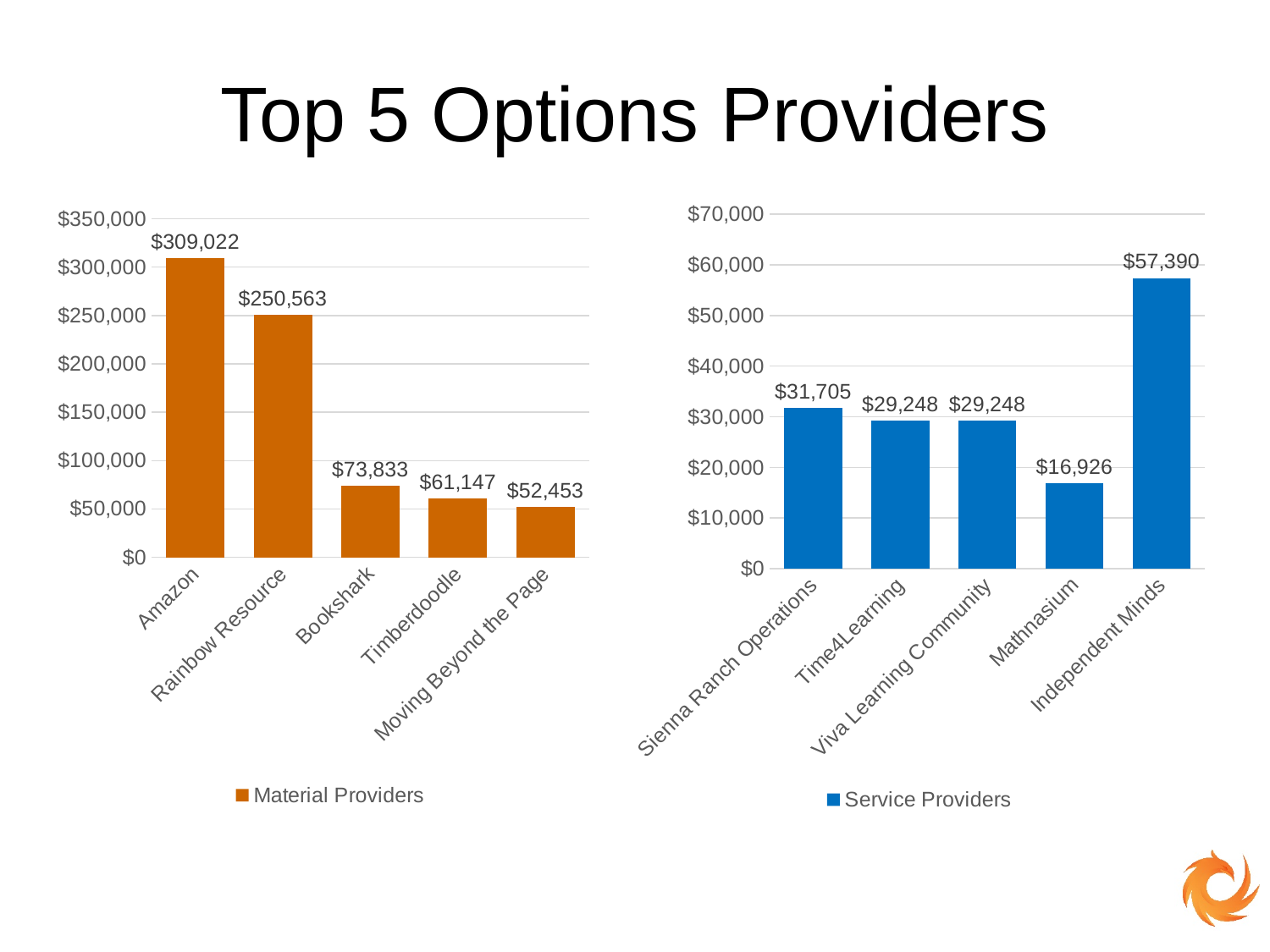
On the right chart (Service Providers), what is the difference between the values for Independent Minds and Mathnasium? $40,464 What kind of chart is the left chart (Material Providers)? bar chart On the right chart (Service Providers), which is larger, the value for Sienna Ranch Operations or the value for Mathnasium? Sienna Ranch Operations On the right chart (Service Providers), what is the value for Mathnasium? $16,926 On the left chart (Material Providers), what is the value for Amazon? $309,022 On the left chart (Material Providers), which category has the lowest value? Moving Beyond the Page How many categories are shown on the right chart (Service Providers)? 5 On the right chart (Service Providers), what is the value for Time4Learning? $29,248 On the right chart (Service Providers), which category has the highest value? Independent Minds What is the legend entry shown below the right chart? Service Providers On the left chart (Material Providers), what is the difference between the values for Amazon and Rainbow Resource? $58,459 On the left chart (Material Providers), is the value for Bookshark greater or less than $100,000? less